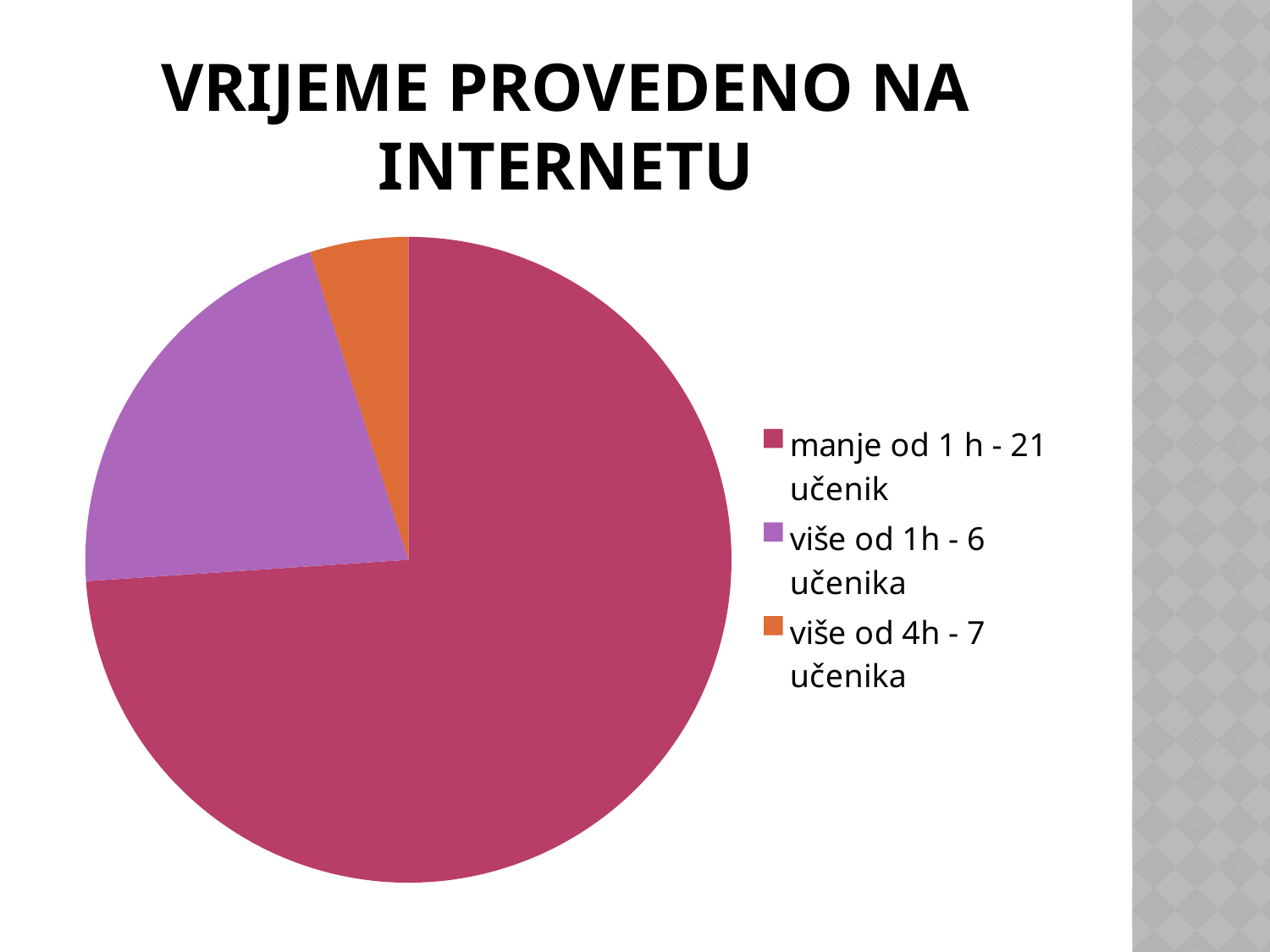
Which colour represents the category 'više od 4h - 7 učenika' in the pie chart? Orange Which category takes up the largest slice of the pie? manje od 1 h - 21 učenik What is the title of the chart on the slide? VRIJEME PROVEDENO NA INTERNETU How many entries does the legend list? 3 How many students are listed in the legend for the category 'manje od 1 h'? 21 učenik How many categories (slices) does the pie chart have? 3 How many students are listed in the legend for the category 'više od 4h'? 7 učenika What kind of chart is shown on the slide? Pie chart How many students are listed in the legend for the category 'više od 1h'? 6 učenika According to the legend, how many more students are in 'manje od 1 h' than in 'više od 1h'? 15 Is the slice for 'manje od 1 h' larger or smaller than the slice for 'više od 1h'? Larger